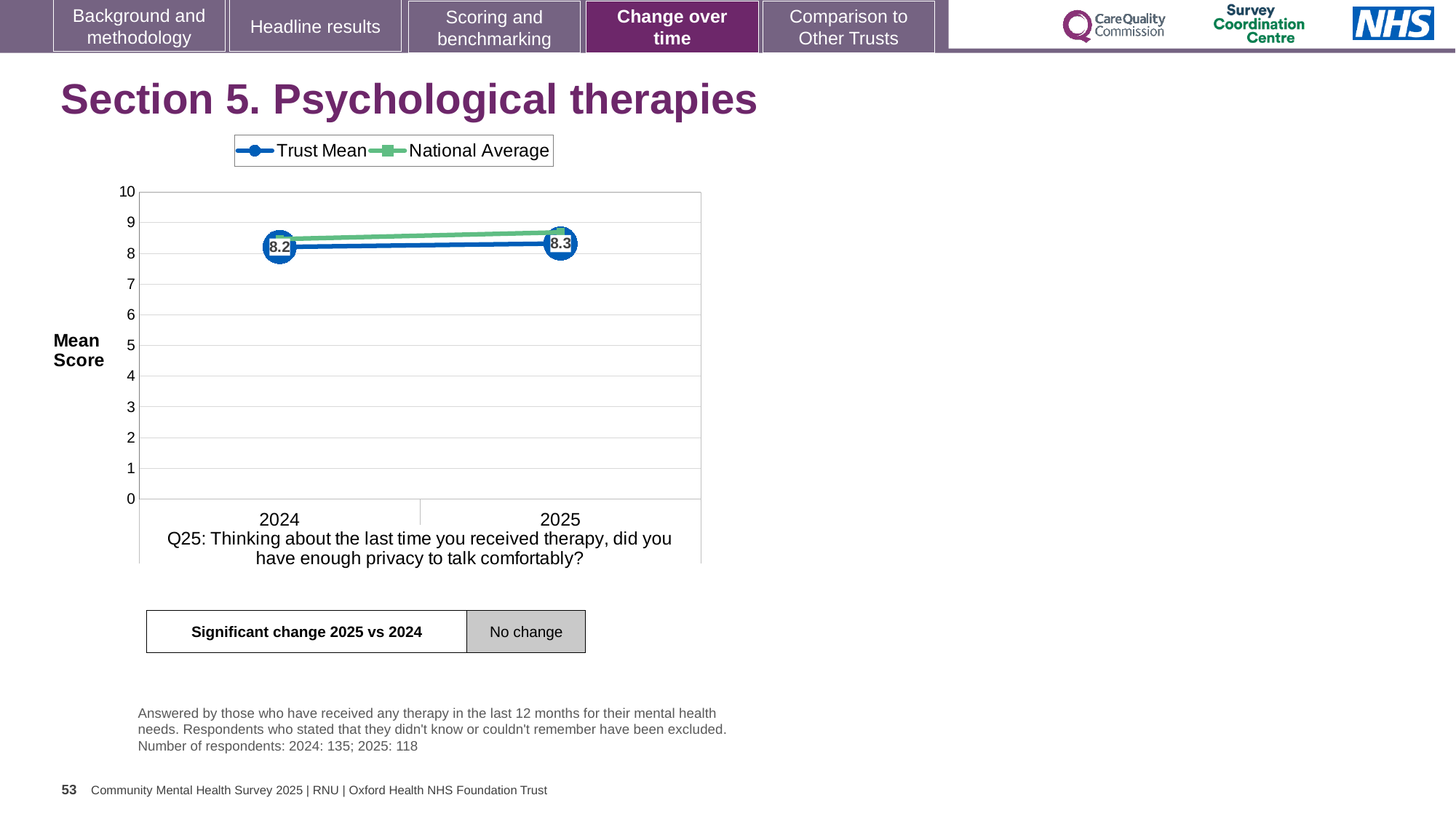
How many series does the legend list? 2 How many years are plotted on the x axis? 2 Is the National Average value for 2024 greater or less than 5? greater Which year has the higher Trust Mean score? 2025 What is the Trust Mean score for 2025? 8.3 What is the difference between the Trust Mean in 2025 and in 2024? 0.1 What are the two series named in the legend? Trust Mean and National Average Is the National Average value for 2025 greater or less than 8? greater What kind of chart is shown on the slide? Line chart Does the Trust Mean rise or fall from 2024 to 2025? Rise What is the Trust Mean score for 2024? 8.2 What is the label on the y axis of the chart? Mean Score